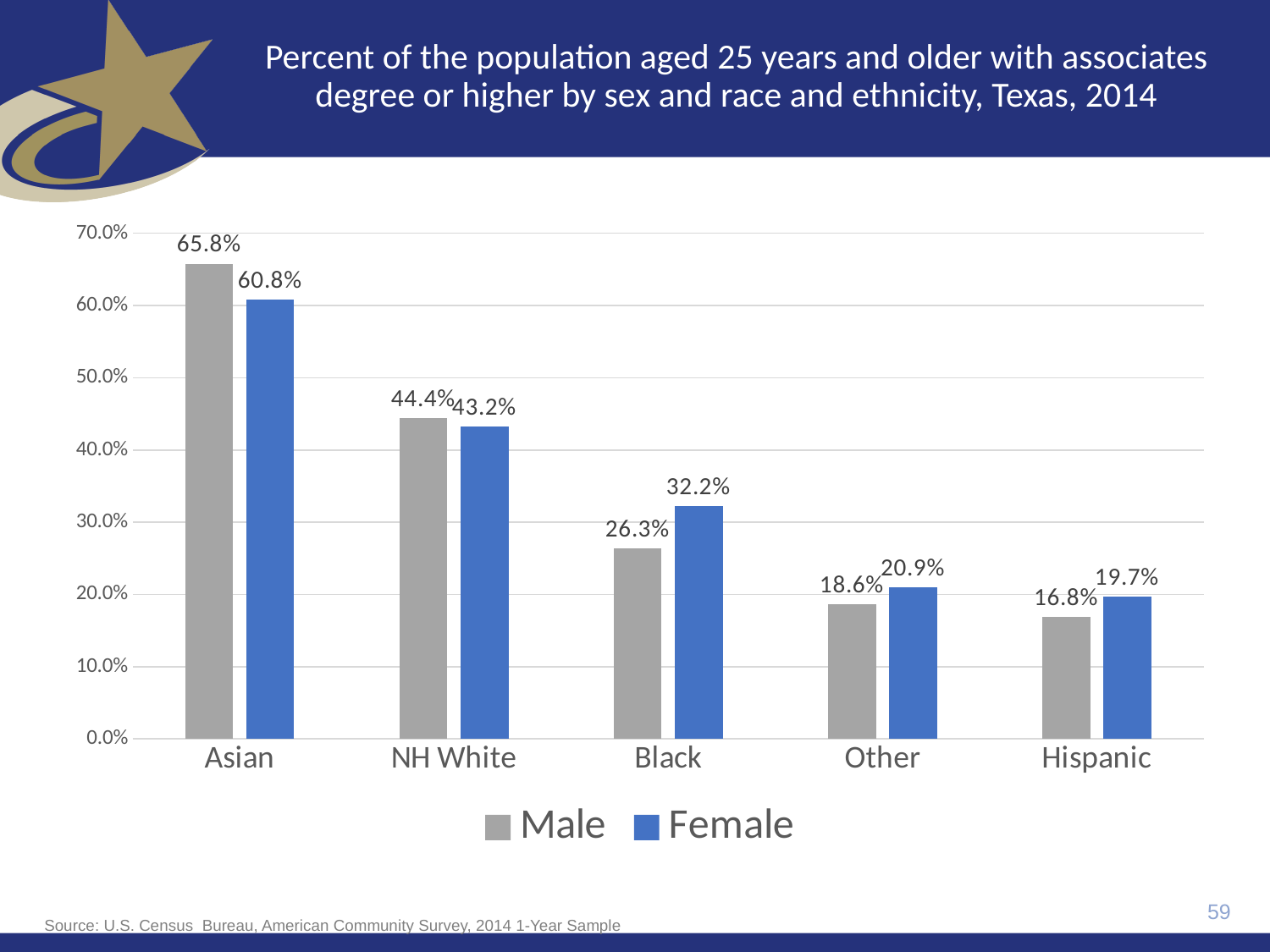
Which category has the lowest Male value? Hispanic Which is larger for NH White, the Male value or the Female value? Male What is the Female value for Black? 32.2% What is the difference between the Male and Female values for Asian? 5.0% Which category has the highest Female value? Asian What kind of chart is shown on the slide? bar chart What is the Male value for Asian? 65.8% Is the Male value for Black greater or less than 30.0%? less What is the difference between the Female and Male values for Black? 5.9% How many series does the legend list? 2 What is the Female value for Hispanic? 19.7% How many race and ethnicity categories are shown on the x axis? 5